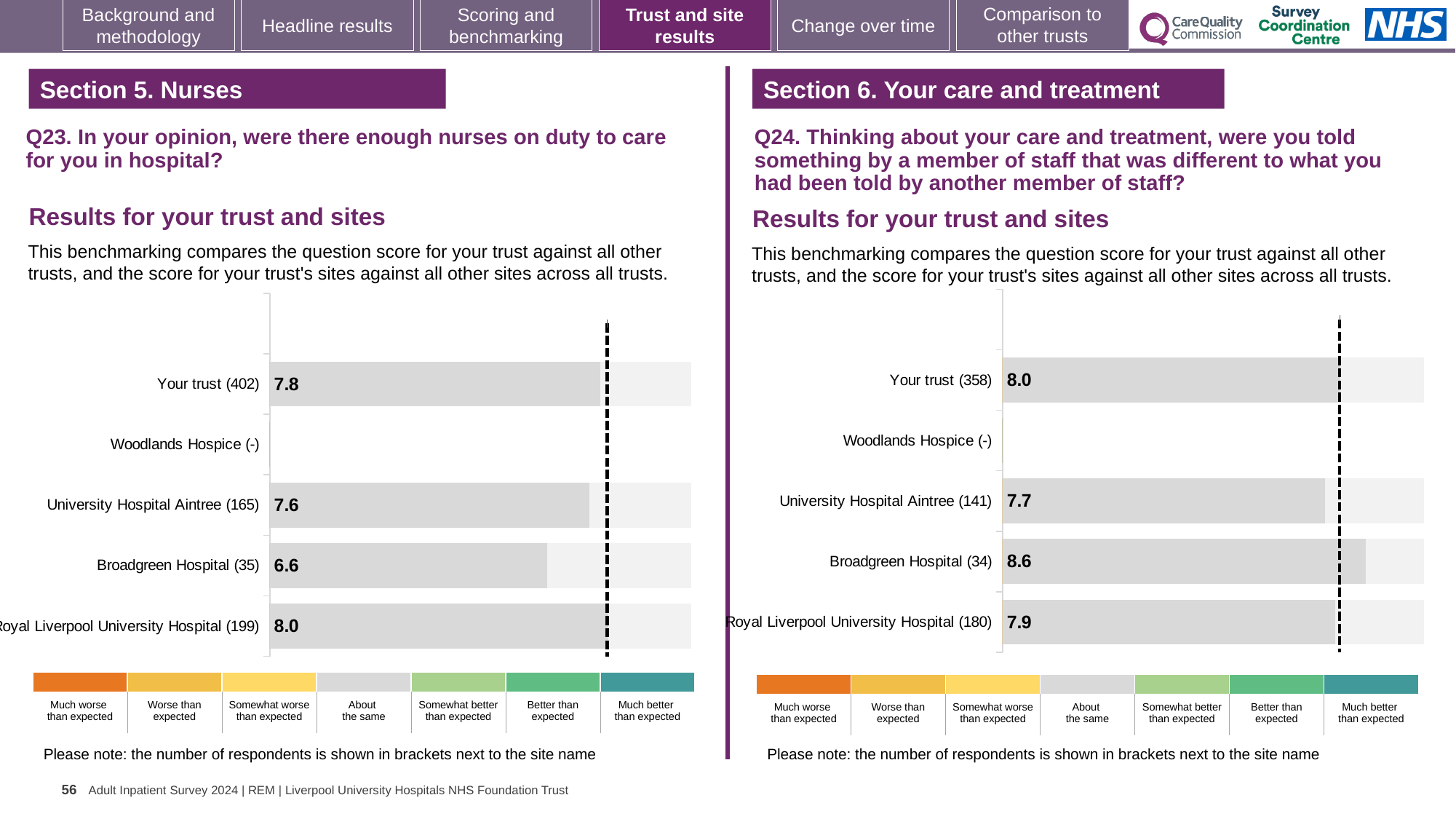
In the Q24 chart on the right, what is the difference between the scores for Broadgreen Hospital and Your trust? 0.6 In the Q24 chart on the right, which site or trust has the lowest score? University Hospital Aintree In the Q23 chart on the left, what is the score for Your trust? 7.8 What kind of chart is the Q24 chart on the right? Bar chart How many sites or trusts are listed on the Q23 chart on the left? 5 In the Q24 chart on the right, which site or trust has the highest score? Broadgreen Hospital In the Q23 chart on the left, which site or trust has the lowest score? Broadgreen Hospital In the Q24 chart on the right, what is the score for University Hospital Aintree? 7.7 In the Q23 chart on the left, what is the score for Broadgreen Hospital? 6.6 In the Q24 chart on the right, which has the larger score, Your trust or Royal Liverpool University Hospital? Your trust In the Q23 chart on the left, which site or trust has the highest score? Royal Liverpool University Hospital In the Q23 chart on the left, what is the difference between the scores for Royal Liverpool University Hospital and Broadgreen Hospital? 1.4